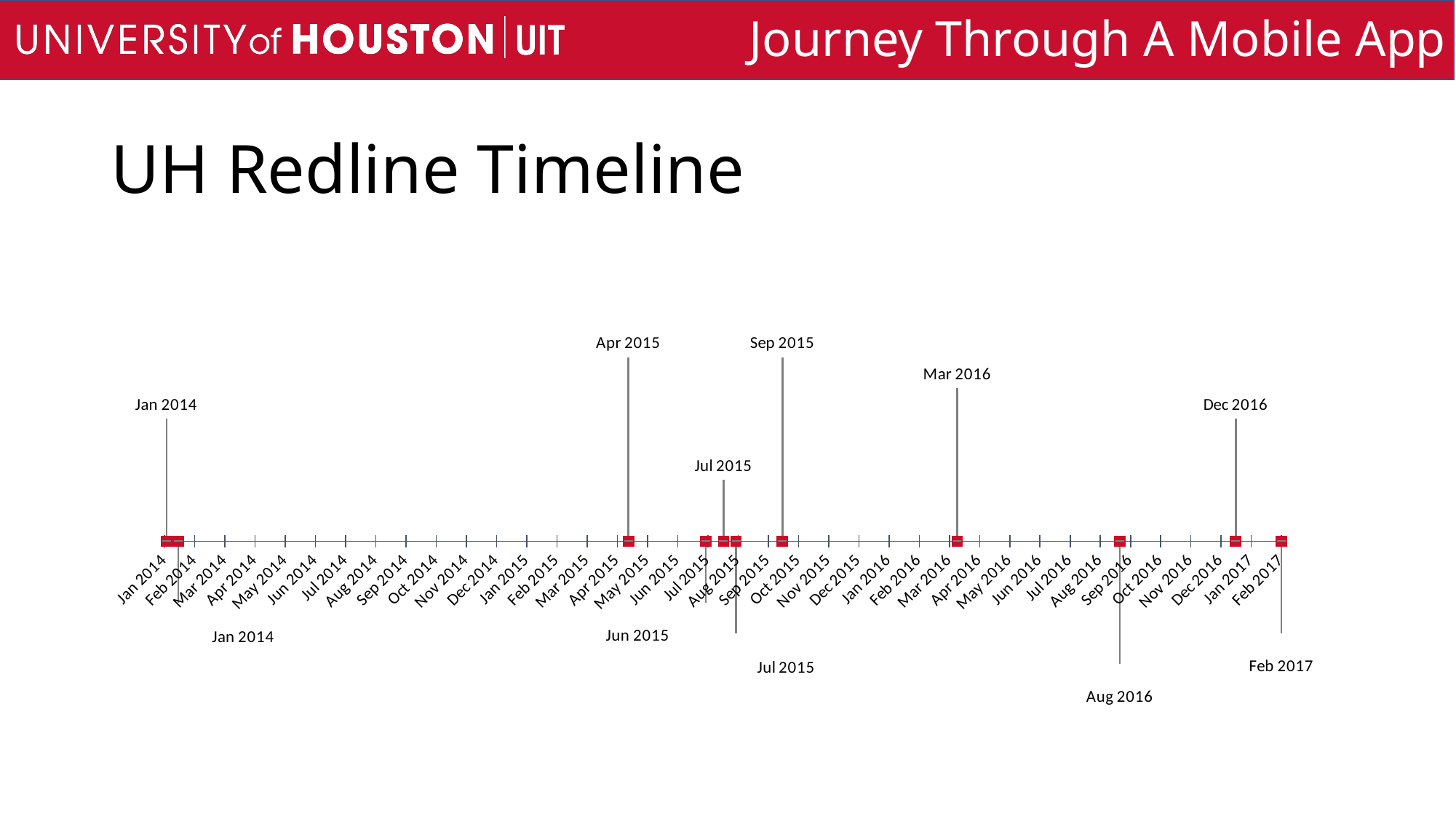
Which milestone date appears twice as a label on the timeline in 2015? Jul 2015 What is the title of the chart on the slide? UH Redline Timeline What is the latest milestone date labelled on the timeline? Feb 2017 What is the first month shown on the timeline's axis? Jan 2014 How many milestone date labels are shown on the timeline? 11 Which milestone date is labelled immediately before Feb 2017 on the timeline? Dec 2016 Which milestone is labelled between Sep 2015 and Aug 2016 on the timeline? Mar 2016 Which milestone date is labelled immediately after Apr 2015 on the timeline? Jun 2015 What is the last month shown on the timeline's axis? Feb 2017 What is the earliest milestone date labelled on the timeline? Jan 2014 What kind of chart is shown on the slide? Timeline chart Which comes later on the timeline, the Aug 2016 milestone or the Mar 2016 milestone? Aug 2016